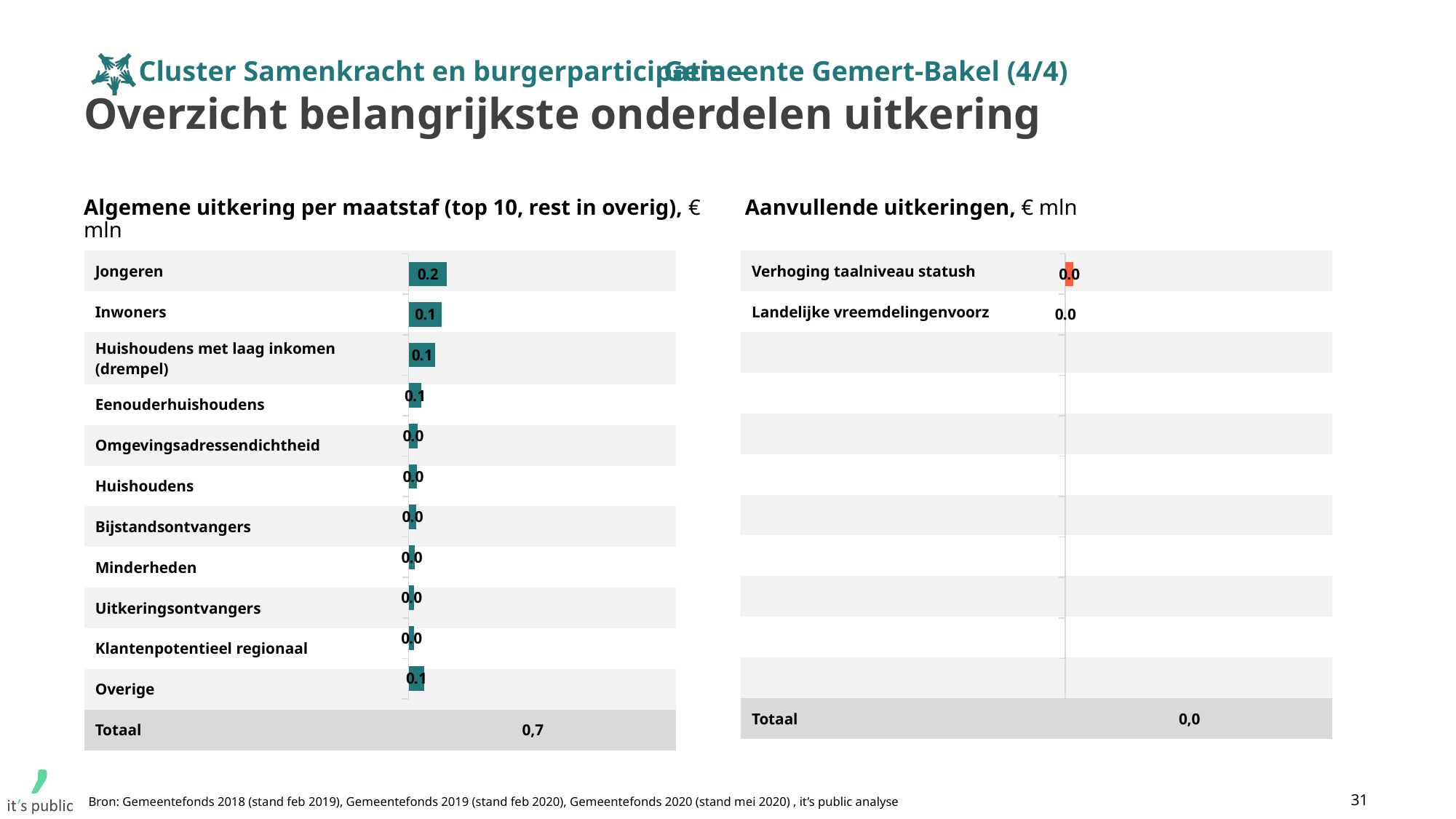
In the chart 'Algemene uitkering per maatstaf', what is the value for Bijstandsontvangers? 0.0 In the chart 'Algemene uitkering per maatstaf', what is the value for Overige? 0.1 In the chart 'Algemene uitkering per maatstaf', what is the Totaal shown? 0,7 In the chart 'Algemene uitkering per maatstaf', which is larger: the value for Jongeren or the value for Huishoudens? Jongeren What kind of chart is 'Algemene uitkering per maatstaf'? Bar chart In the chart 'Aanvullende uitkeringen', what is the value for Verhoging taalniveau statush? 0.0 In the chart 'Algemene uitkering per maatstaf', which category has the highest value? Jongeren In the chart 'Algemene uitkering per maatstaf', what is the value for Inwoners? 0.1 In the chart 'Algemene uitkering per maatstaf', what is the value for Jongeren? 0.2 In the chart 'Aanvullende uitkeringen', how many categories are labelled (excluding Totaal)? 2 In the chart 'Algemene uitkering per maatstaf', what is the difference between the values for Jongeren and Inwoners? 0.1 In the chart 'Algemene uitkering per maatstaf', how many categories are shown (including Overige, excluding Totaal)? 11